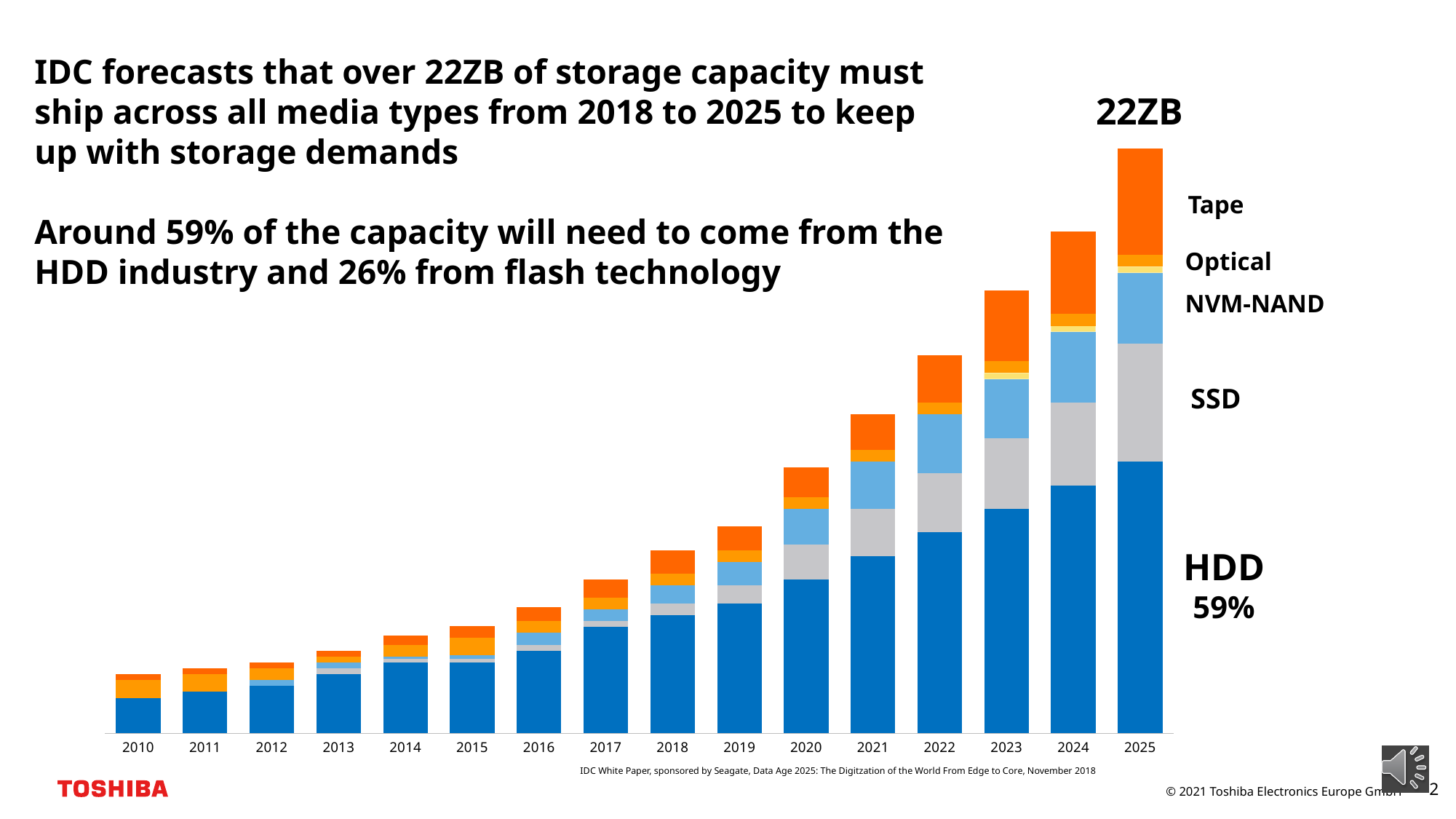
Which is larger in 2025, the HDD segment or the SSD segment? HDD Which media type is labelled at the top of the stacked bars? Tape What is the first year shown on the x axis? 2010 Do the total bar heights rise or fall from 2010 to 2025? Rise How many years are shown along the x axis of the chart? 16 Which is larger, the total bar for 2024 or the total bar for 2020? 2024 Which year has the shortest stacked bar? 2010 Which media type forms the bottom (largest) segment of each bar? HDD What percentage share is labelled next to HDD on the chart? 59% What kind of chart is shown on the slide? Stacked bar chart How many storage media types (series) are labelled on the chart? 5 Which year has the tallest stacked bar? 2025